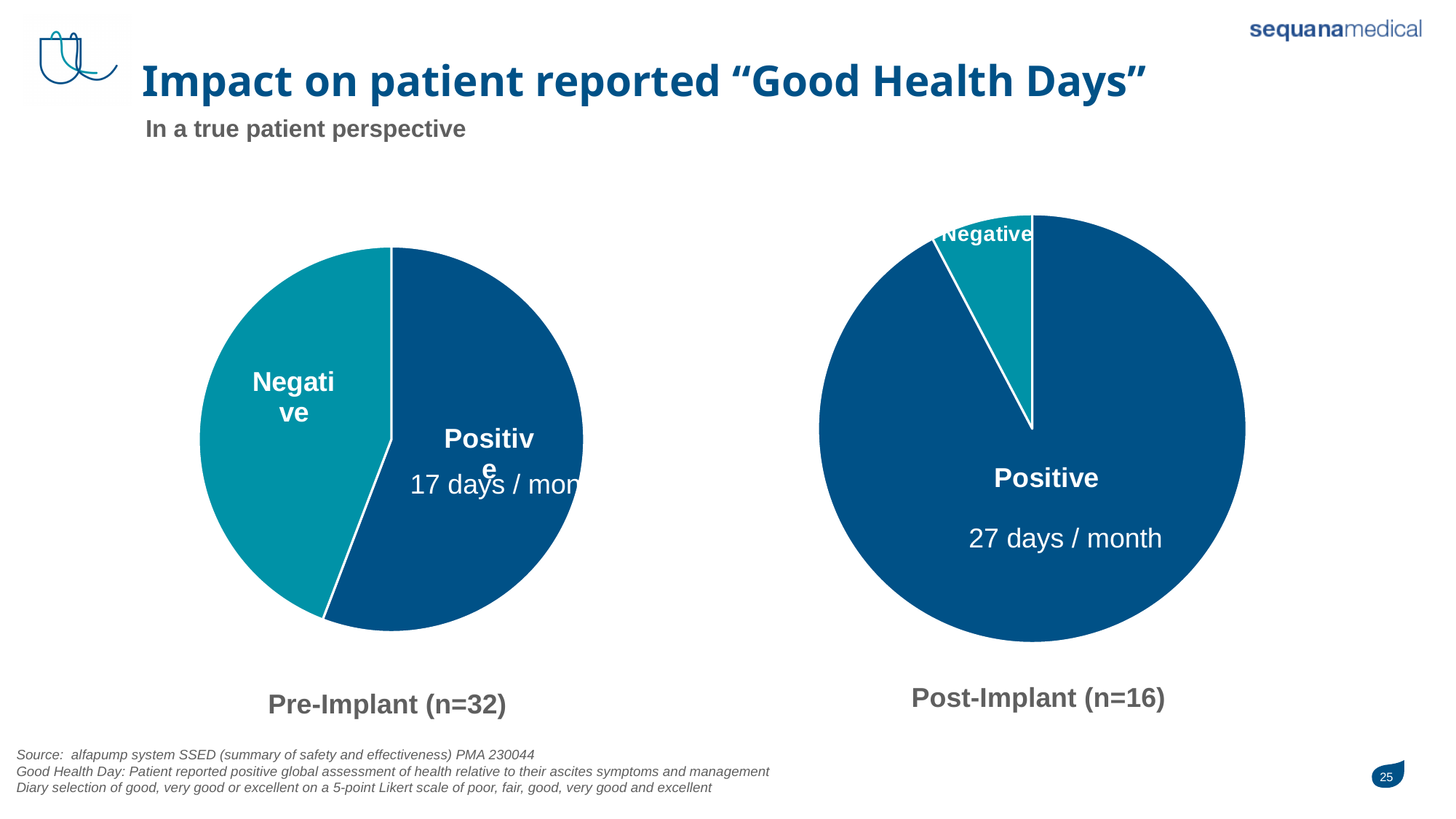
What kind of chart is the Post-Implant (n=16) chart? pie chart What is the title of the chart on the left side of the slide? Pre-Implant (n=32) What is the difference in good health days per month between the Post-Implant and Pre-Implant charts? 10 days / month In the Post-Implant (n=16) chart, which slice is larger, Positive or Negative? Positive In the Pre-Implant (n=32) chart, which slice is larger, Positive or Negative? Positive What kind of chart is the Pre-Implant (n=32) chart? pie chart In the Post-Implant (n=16) chart, which slice is the largest? Positive In the Pre-Implant (n=32) chart, which slice is the smallest? Negative How many good health days per month are shown on the Pre-Implant (n=32) chart? 17 days / month How many slices does the Post-Implant (n=16) pie chart have? 2 How many good health days per month are shown on the Post-Implant (n=16) chart? 27 days / month How many slices does the Pre-Implant (n=32) pie chart have? 2